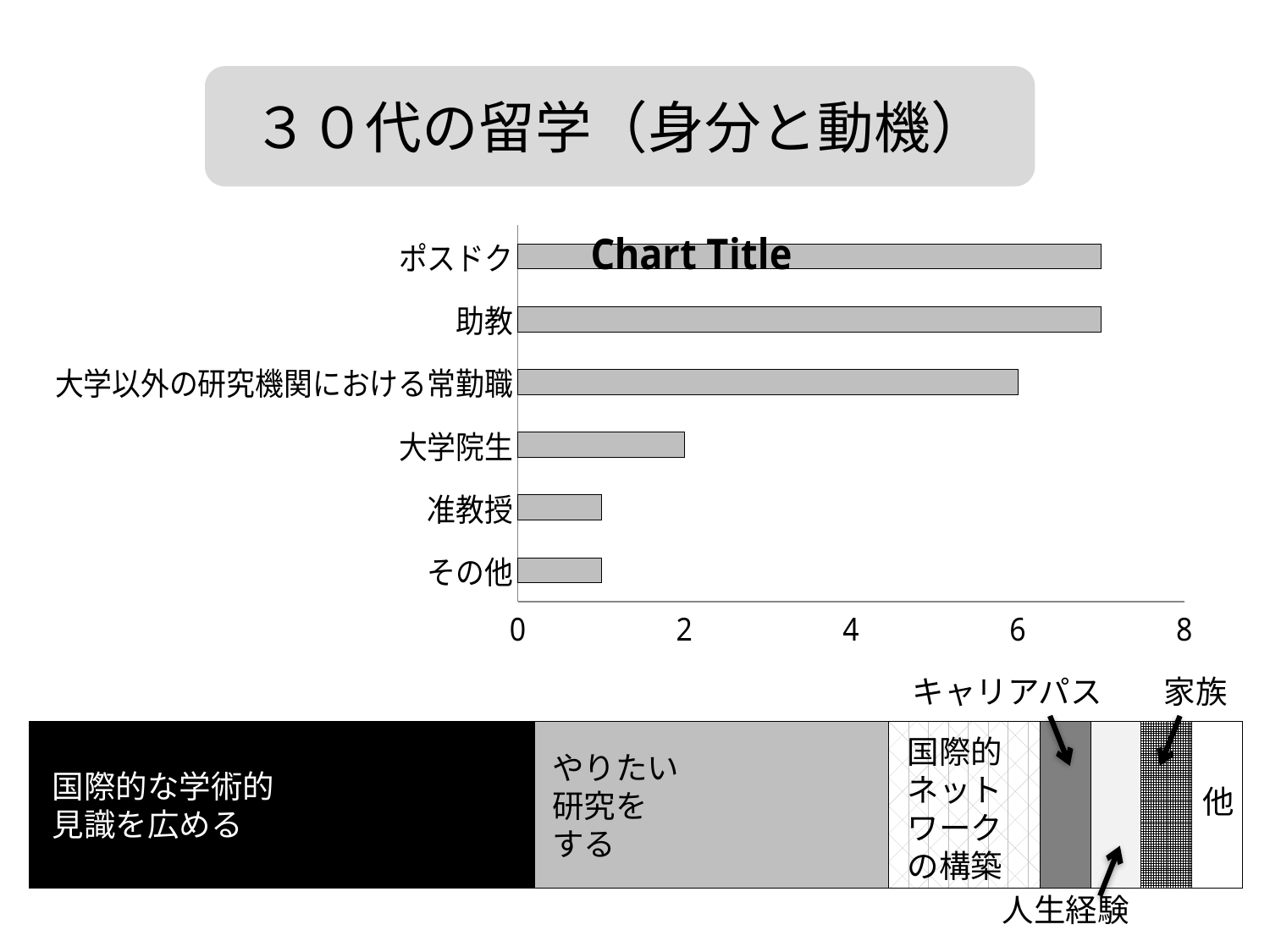
In the upper bar chart, which is larger, the value for ポスドク or the value for 大学院生? ポスドク In the upper bar chart, what is the value for 大学以外の研究機関における常勤職? 6 In the upper bar chart, is the value for ポスドク greater or less than 6? greater What is the title shown on the upper chart? Chart Title In the upper bar chart, what is the value for 大学院生? 2 In the upper bar chart, is the value for 助教 greater or less than 8? less In the upper bar chart, which is larger, the value for その他 or the value for 大学以外の研究機関における常勤職? 大学以外の研究機関における常勤職 In the upper bar chart, is the value for 准教授 greater or less than 2? less In the stacked bar at the bottom of the slide, which segment is the largest? 国際的な学術的見識を広める What kind of chart is the upper chart on the slide? bar chart How many segments does the stacked bar at the bottom of the slide contain? 7 How many categories are shown in the upper bar chart? 6